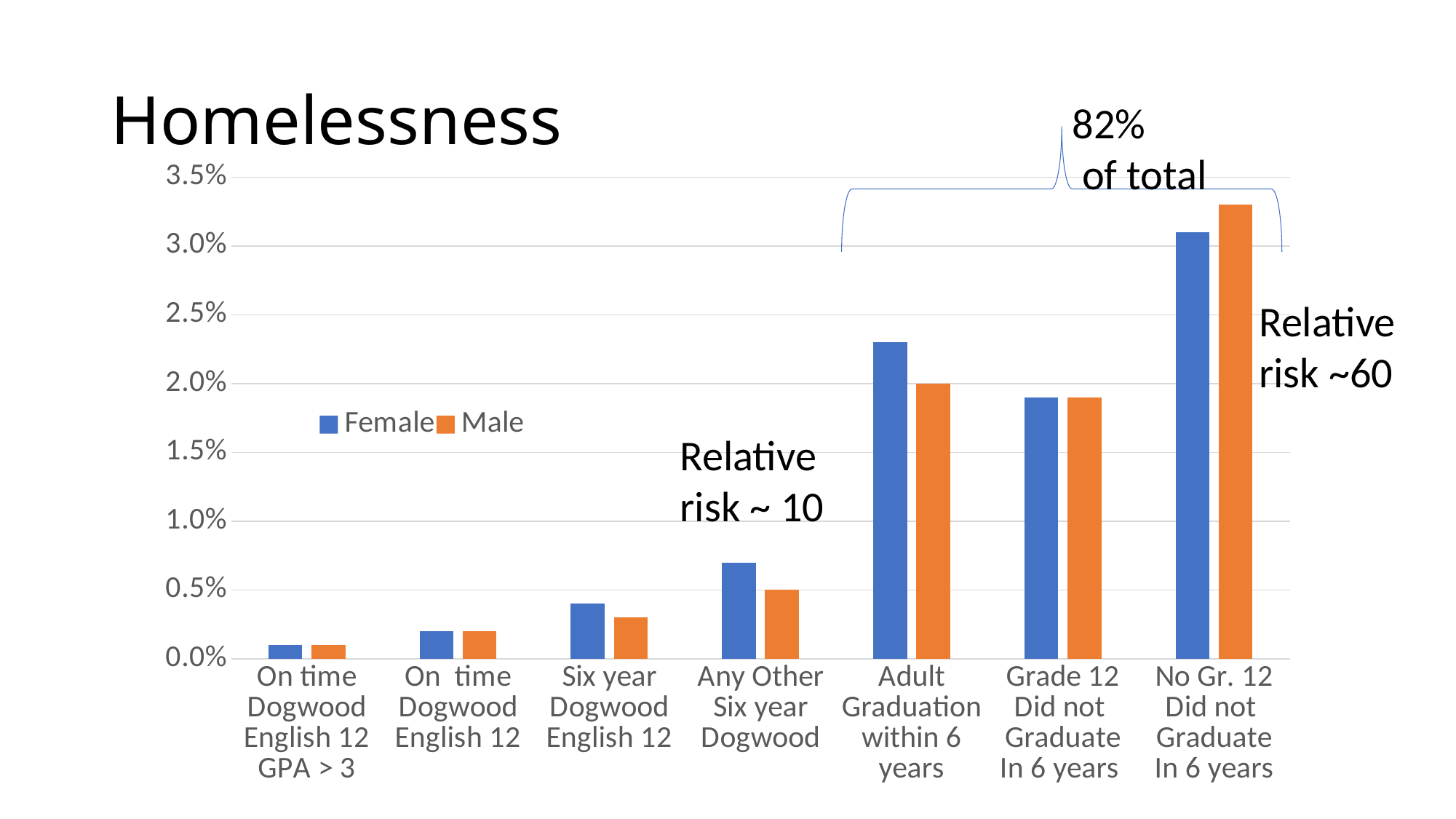
Which category has the lowest Female value? On time Dogwood English 12 GPA > 3 Is the Female value for Grade 12 Did not Graduate In 6 years greater or less than 2.0%? less How many categories are shown along the x axis? 7 For No Gr. 12 Did not Graduate In 6 years, which is larger, the Female or the Male value? Male Is the Female value for Any Other Six year Dogwood greater or less than 0.5%? greater Which category has the highest Male value? No Gr. 12 Did not Graduate In 6 years What is the title of the chart? Homelessness Is the Female value for No Gr. 12 Did not Graduate In 6 years greater or less than 3.0%? greater For Adult Graduation within 6 years, which is larger, the Female or the Male value? Female How many series does the legend list? 2 Do the values generally rise or fall moving from left to right along the x axis? rise What kind of chart is shown on the slide? bar chart